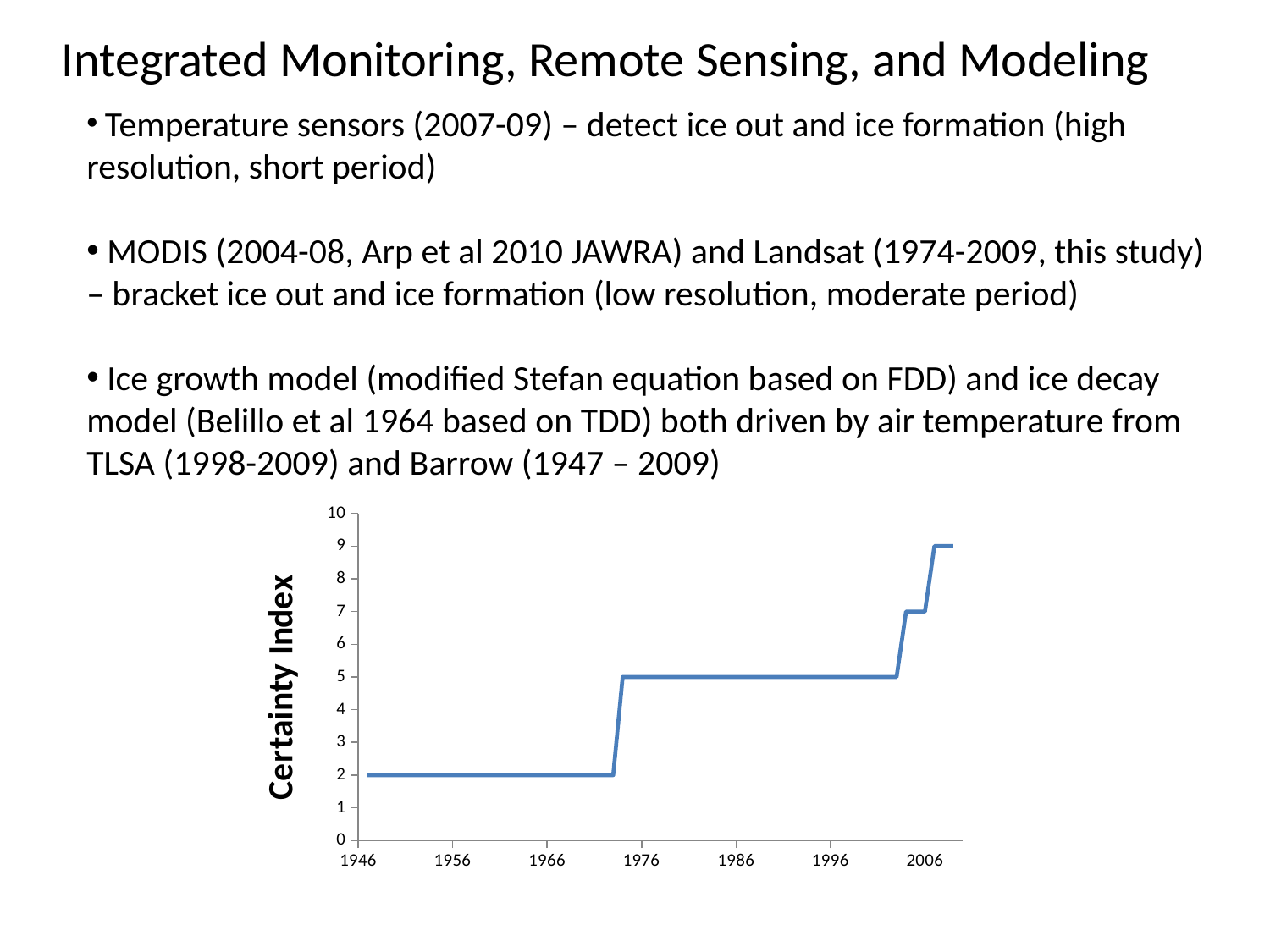
What is the difference between the Certainty Index in 1986 and in 1956? 3 Does the Certainty Index rise or fall over time along the x axis? rise What is the label on the y axis of the chart? Certainty Index What is the Certainty Index value in 1956? 2 What is the lowest Certainty Index value shown on the chart? 2 What is the highest Certainty Index value reached on the chart? 9 Which year has the larger Certainty Index, 1966 or 1976? 1976 What kind of chart is shown on the slide? line chart Is the Certainty Index value for 1966 greater or less than 4? less What is the Certainty Index value in 1996? 5 What is the Certainty Index value in 1986? 5 Is the Certainty Index value for 2006 greater or less than 6? greater